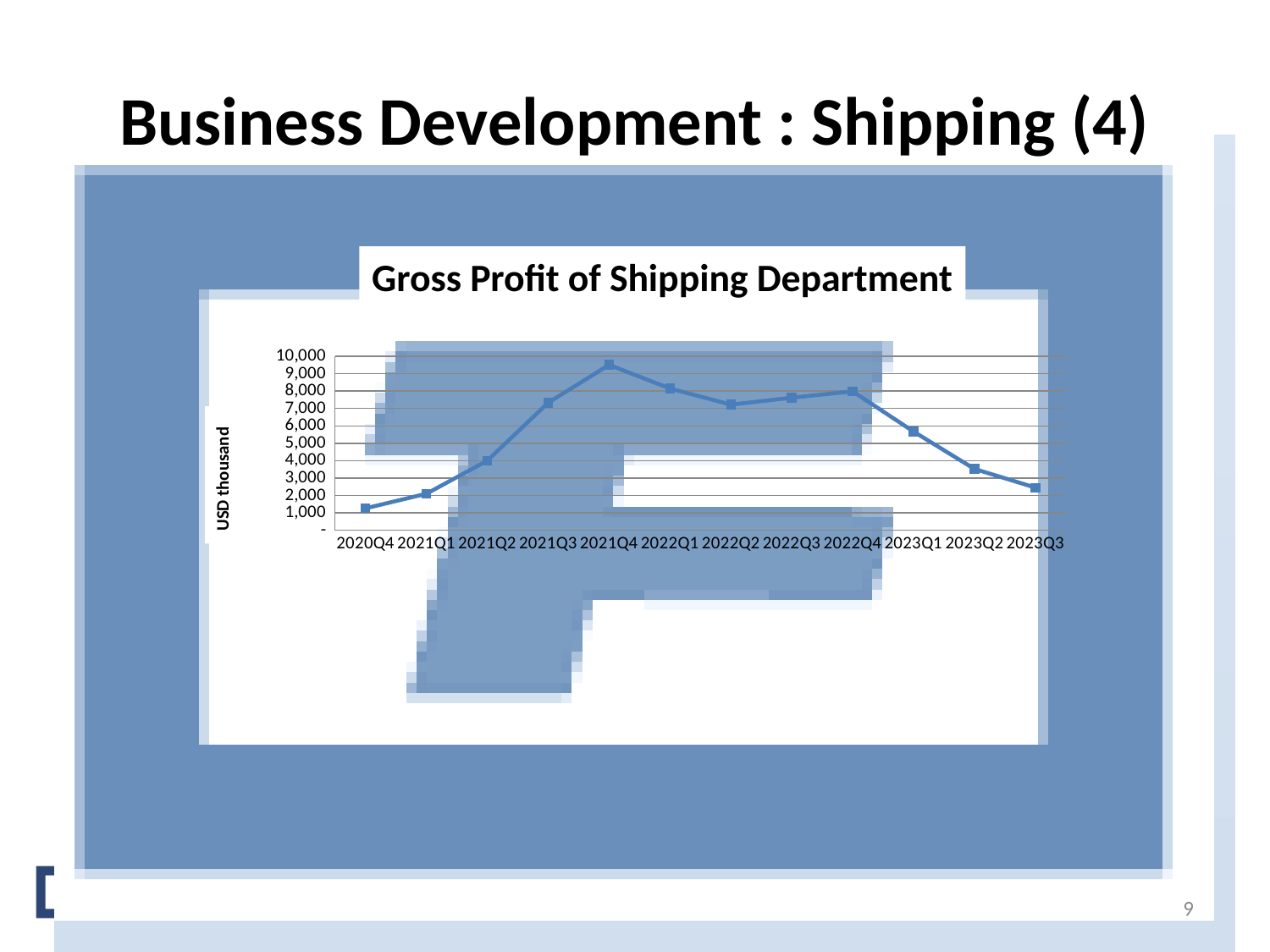
Is the value for 2023Q3 greater or less than 3,000? less Is the value for 2023Q1 greater or less than 5,000? greater What is the title of the chart? Gross Profit of Shipping Department What kind of chart is shown on the slide? line chart Is the value for 2020Q4 greater or less than 2,000? less What unit is shown on the vertical axis label of the chart? USD thousand Which quarter has the highest gross profit in the chart? 2021Q4 How many quarters are plotted on the x axis of the chart? 12 Which is larger, the value for 2021Q3 or the value for 2023Q2? 2021Q3 Do the values rise or fall from 2022Q4 to 2023Q3? fall Which quarter has the lowest gross profit in the chart? 2020Q4